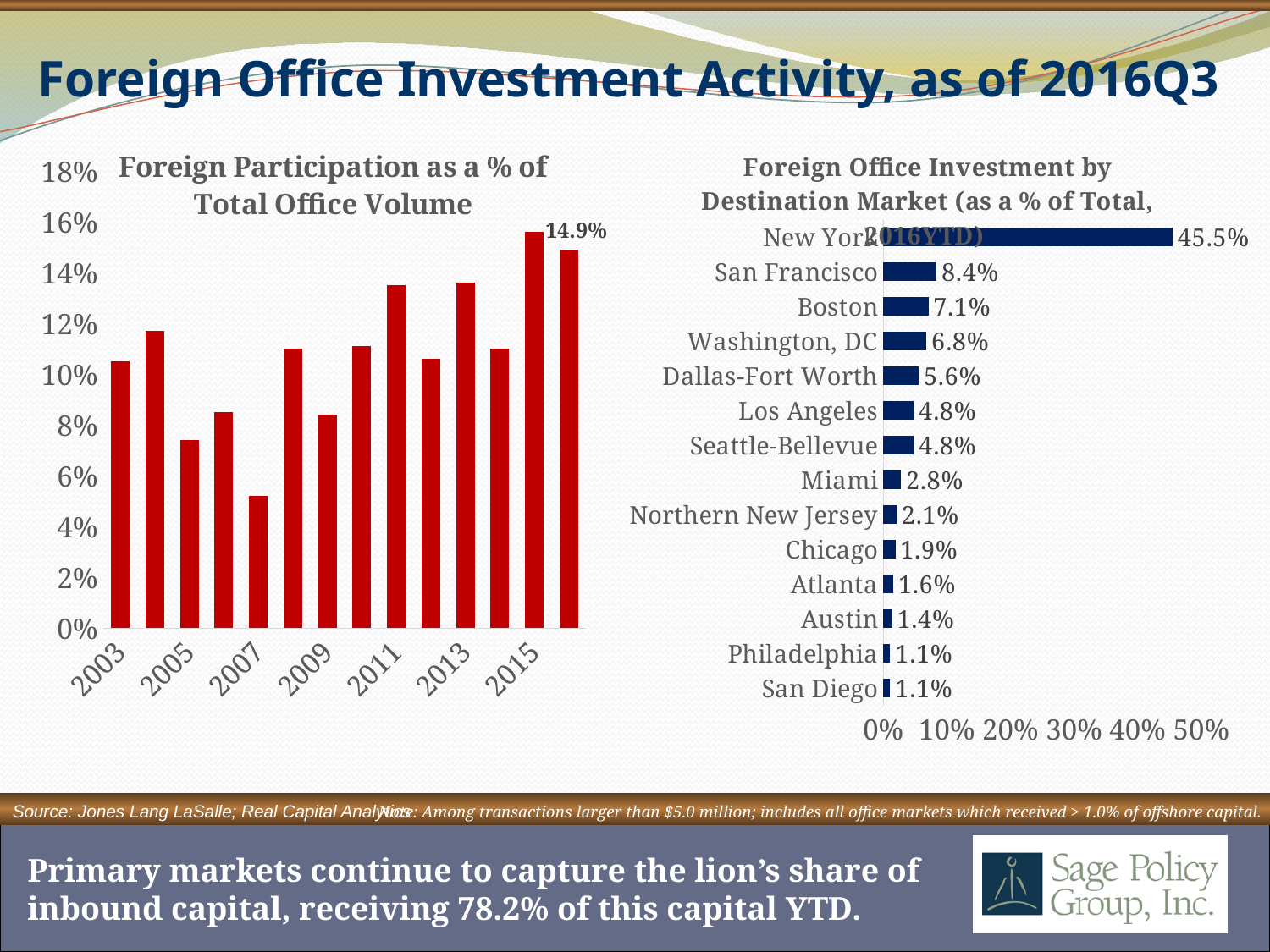
What kind of chart is the 'Foreign Participation as a % of Total Office Volume' chart? bar chart In the 'Foreign Office Investment by Destination Market' chart, which is larger: Washington, DC or Dallas-Fort Worth? Washington, DC In the 'Foreign Office Investment by Destination Market' chart, what percentage is shown for New York? 45.5% How many destination markets are listed in the 'Foreign Office Investment by Destination Market' chart? 14 In the 'Foreign Participation as a % of Total Office Volume' chart, what value is printed as a data label on the rightmost bar? 14.9% In the 'Foreign Participation as a % of Total Office Volume' chart, is the value for 2015 greater or less than 14%? greater In the 'Foreign Office Investment by Destination Market' chart, what is the value for Miami? 2.8% In the 'Foreign Office Investment by Destination Market' chart, which market has the highest share? New York How many bars are plotted in the 'Foreign Participation as a % of Total Office Volume' chart? 14 In the 'Foreign Office Investment by Destination Market' chart, what is the value for Boston? 7.1% In the 'Foreign Participation as a % of Total Office Volume' chart, is the value for 2007 greater or less than 6%? less In the 'Foreign Office Investment by Destination Market' chart, how much larger is New York's share than San Francisco's? 37.1%